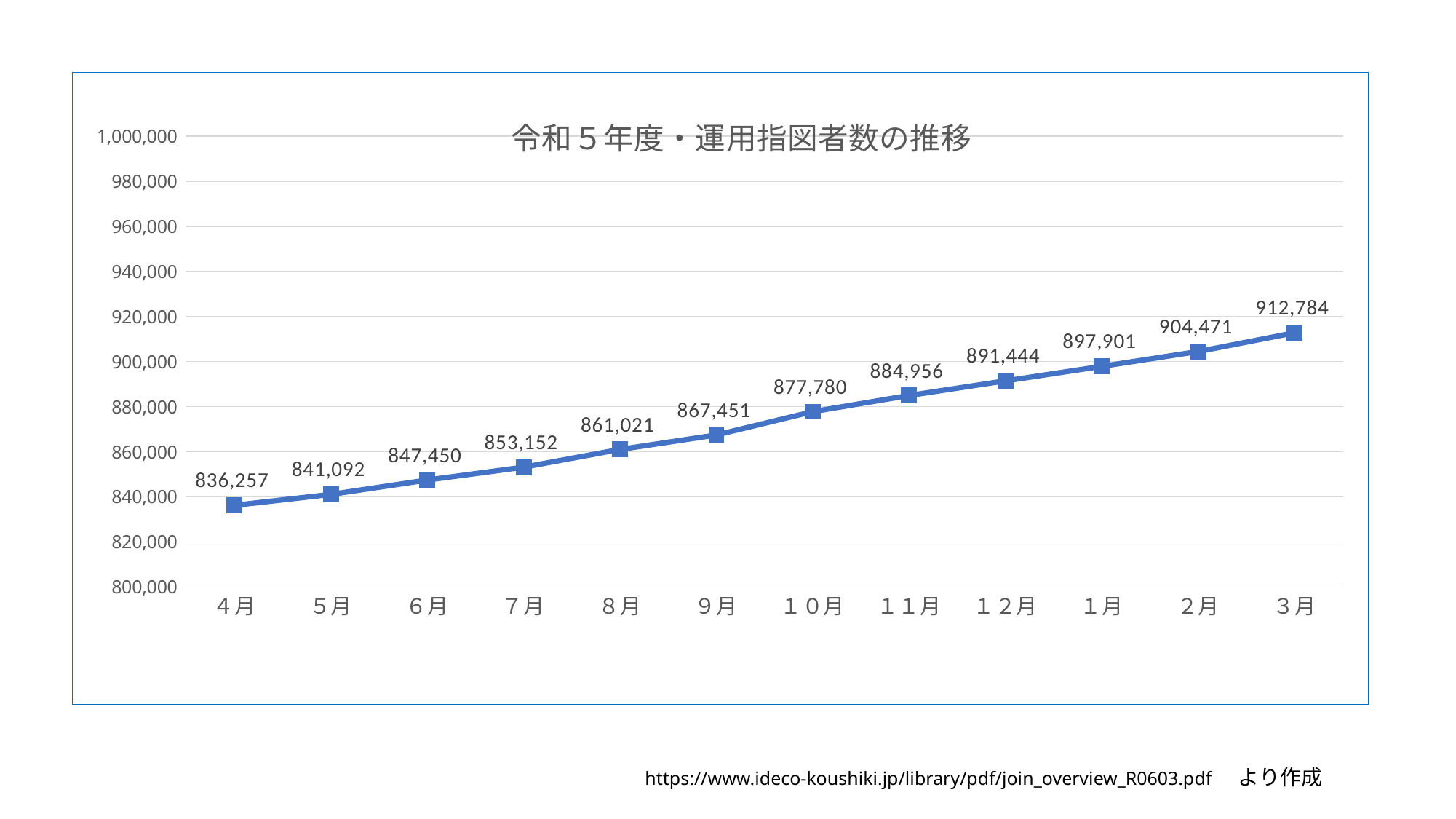
Which month has the lowest value? 4月 Which is larger, the value for 7月 or the value for 12月? 12月 What type of chart is shown on the slide? Line chart Do the values rise or fall from 4月 to 3月? Rise What is the difference between the values for 10月 and 9月? 10,329 What is the title of the chart? 令和５年度・運用指図者数の推移 What is the difference between the values for 3月 and 4月? 76,527 What is the value for 3月? 912,784 What is the value for 10月? 877,780 How many data points are plotted on the chart? 12 Which month has the highest value? 3月 What is the value for 4月? 836,257